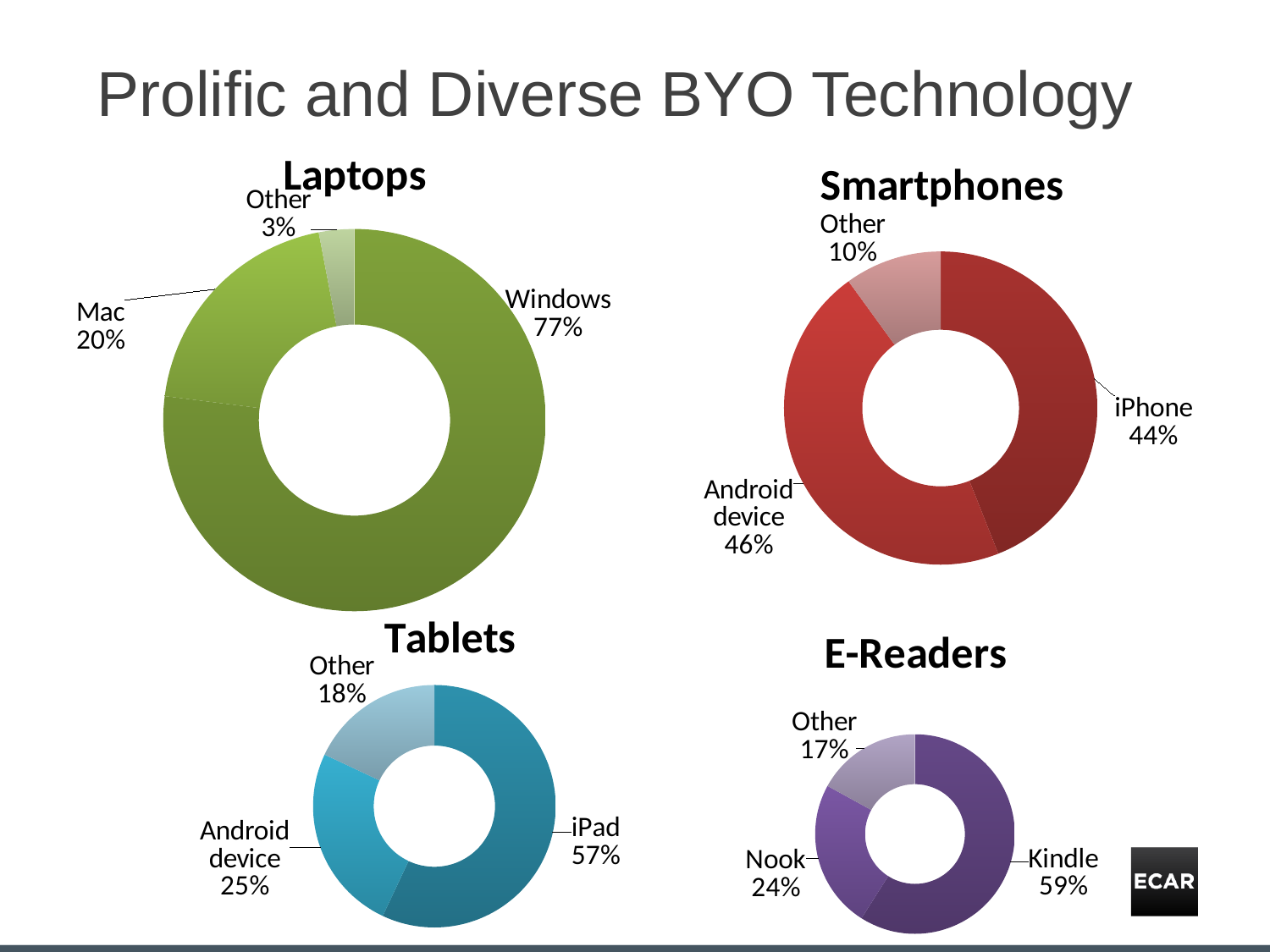
In the E-Readers chart, what share is Nook? 24% In the Laptops chart, which is larger, Mac or Other? Mac In the Smartphones chart, what is the difference between the Android device share and the iPhone share? 2% In the Laptops chart, which category has the smallest share? Other In the Tablets chart, what is the difference between the iPad share and the Android device share? 32% What type of chart is the Tablets chart? Doughnut chart In the Tablets chart, what share is iPad? 57% In the Smartphones chart, what share is Android device? 46% In the E-Readers chart, which category has the largest share? Kindle How many charts are on the slide? 4 How many categories does the Smartphones chart show? 3 In the Laptops chart, what share is Windows? 77%